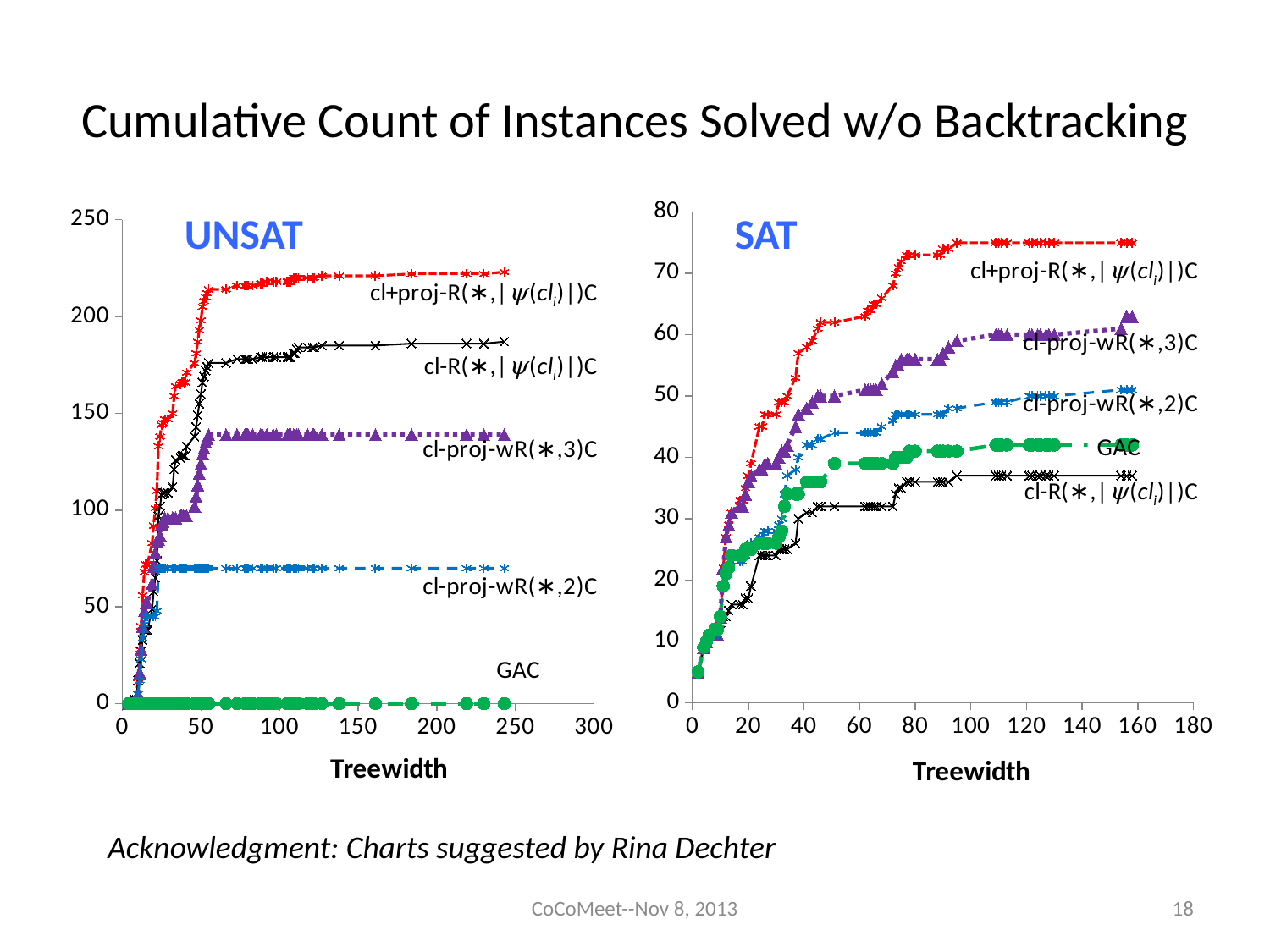
On the SAT chart, which series reaches the highest cumulative count? cl+proj-R(*,|ψ(cl_i)|)C On the SAT chart, at the largest treewidth, which is larger: GAC or cl-R(*,|ψ(cl_i)|)C? GAC On the UNSAT chart, is the final value of cl-proj-wR(*,3)C greater or less than 150? less On the SAT chart, is the final value of cl-R(*,|ψ(cl_i)|)C greater or less than 40? less On the UNSAT chart, which series reaches the highest cumulative count? cl+proj-R(*,|ψ(cl_i)|)C On the SAT chart, which series has the lowest cumulative count at the largest treewidth? cl-R(*,|ψ(cl_i)|)C How many series are plotted on the SAT chart? 5 On the UNSAT chart, which series has the lowest cumulative count? GAC On the SAT chart, is the final value of cl+proj-R(*,|ψ(cl_i)|)C greater or less than 70? greater What kind of chart is the UNSAT chart on the left? line chart What is the x-axis title of the UNSAT chart? Treewidth